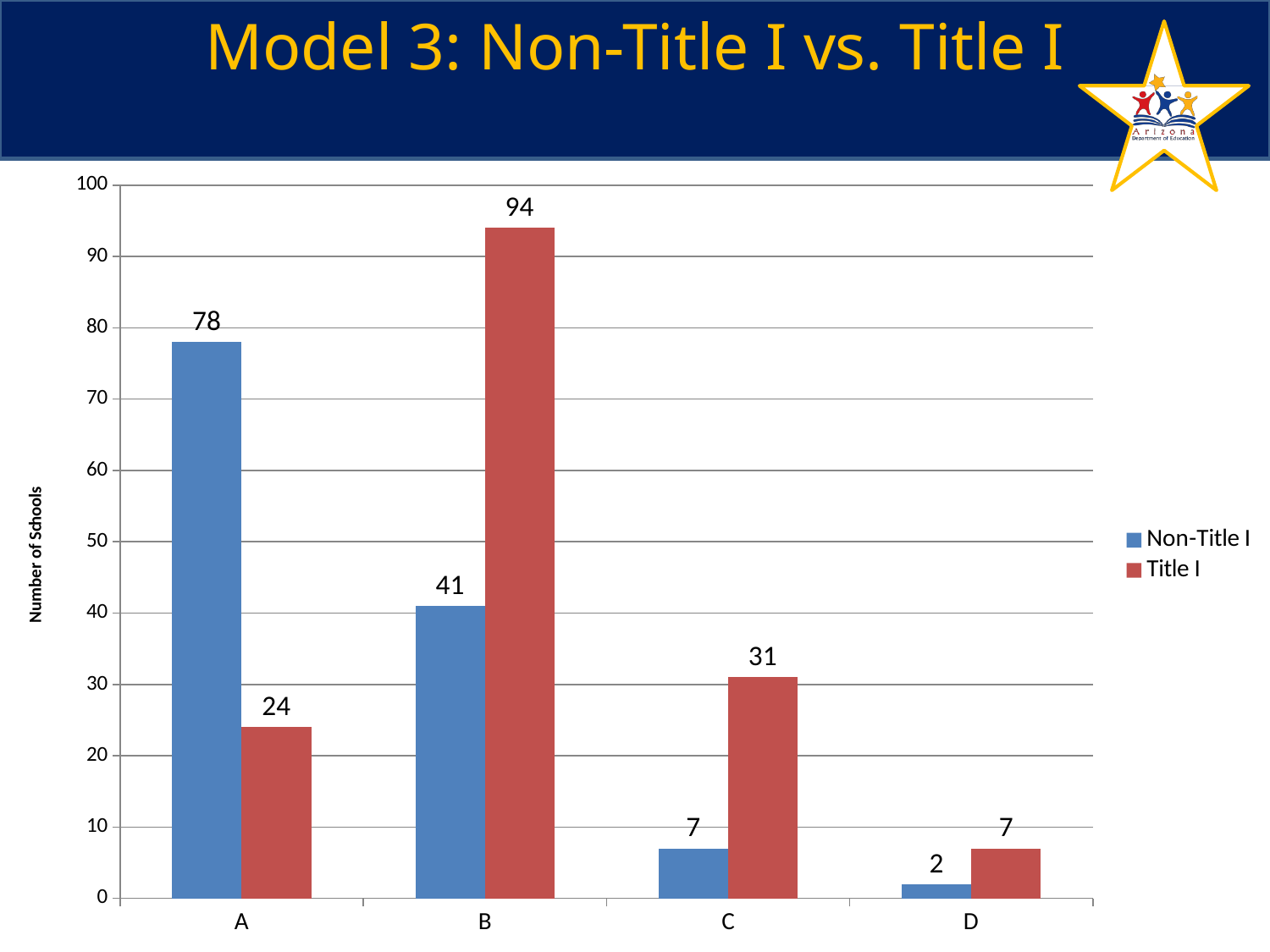
What is the number of Non-Title I schools for category D? 2 What is the label of the vertical axis? Number of Schools What kind of chart is shown on the slide? Bar chart What is the number of Title I schools for category B? 94 How many series does the legend list? 2 What is the number of Title I schools for category C? 31 What is the difference between the Title I and Non-Title I values for category B? 53 What is the number of Non-Title I schools for category A? 78 How many categories are shown on the x axis? 4 Which category has the lowest number of Non-Title I schools? D Which category has the highest number of Title I schools? B For category A, which series has the larger value, Non-Title I or Title I? Non-Title I